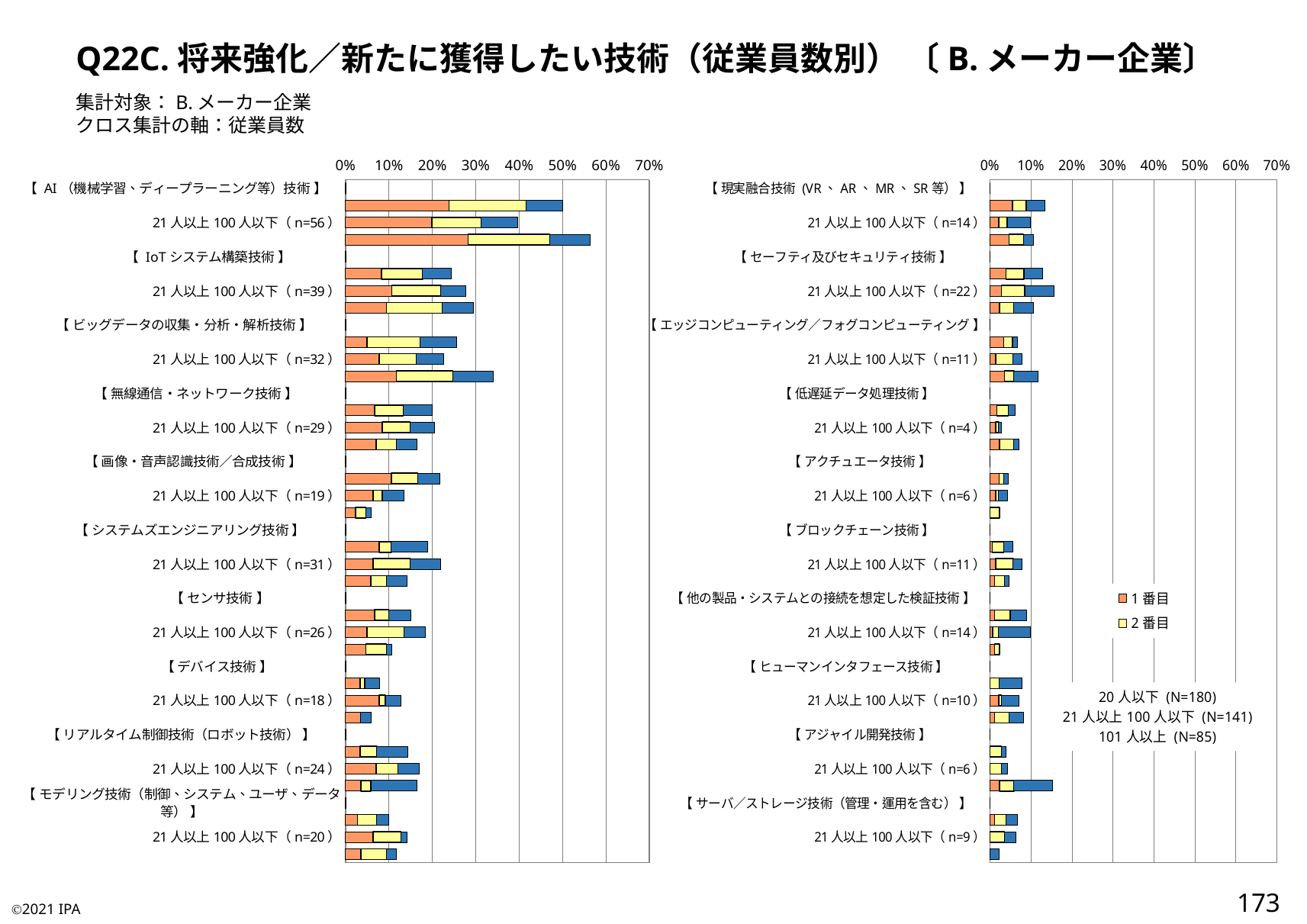
In the right chart, is the total bar for 21人以上100人以下（n=4）under 低遅延データ処理技術 greater or less than 10%? less What is the maximum value shown on the horizontal axis of the right chart? 70% In the right chart, is the first (20人以下) bar under 現実融合技術（VR、AR、MR、SR等）greater or less than 10%? greater In the left chart, is the total bar for 21人以上100人以下（n=56）under AI（機械学習、ディープラーニング等）技術 greater or less than 30%? greater What kind of chart is shown on the left side of the slide? Stacked horizontal bar chart In the left chart, which is longer: the third (101人以上) bar under AI（機械学習、ディープラーニング等）技術 or the third bar under IoTシステム構築技術? AI（機械学習、ディープラーニング等）技術 How many series does the legend on the right chart list? 2 In the left chart, which technology category has the longest bars? AI（機械学習、ディープラーニング等）技術 How many technology categories are shown in the left chart? 10 In the left chart, which is longer: the third (101人以上) bar under ビッグデータの収集・分析・解析技術 or the third bar under 無線通信・ネットワーク技術? ビッグデータの収集・分析・解析技術 What is the n value shown for 21人以上100人以下 under AI（機械学習、ディープラーニング等）技術 in the left chart? n=56